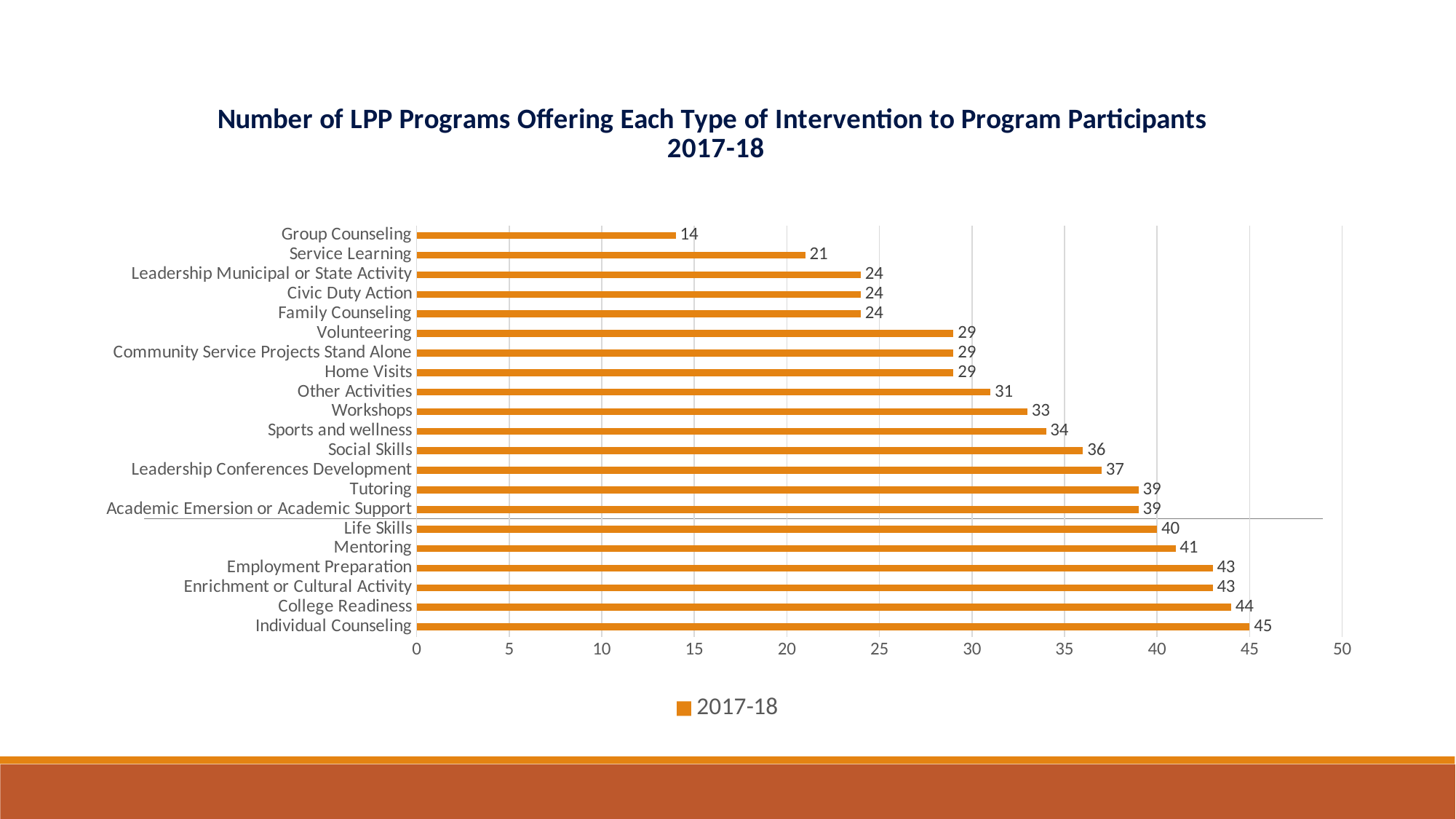
How many programs offered Mentoring? 41 What is the value shown for Group Counseling? 14 What kind of chart is shown on the slide? Bar chart What is the difference between the number of programs offering College Readiness and the number offering Service Learning? 23 How many LPP programs offered Individual Counseling in 2017-18? 45 Which type of intervention was offered by the fewest programs? Group Counseling How many series does the legend list? 1 Which was offered by more programs, Tutoring or Workshops? Tutoring What is the legend entry for the series shown? 2017-18 How many types of intervention are listed on the chart? 21 Is the value for Social Skills greater or less than 35? greater Which type of intervention was offered by the most programs? Individual Counseling